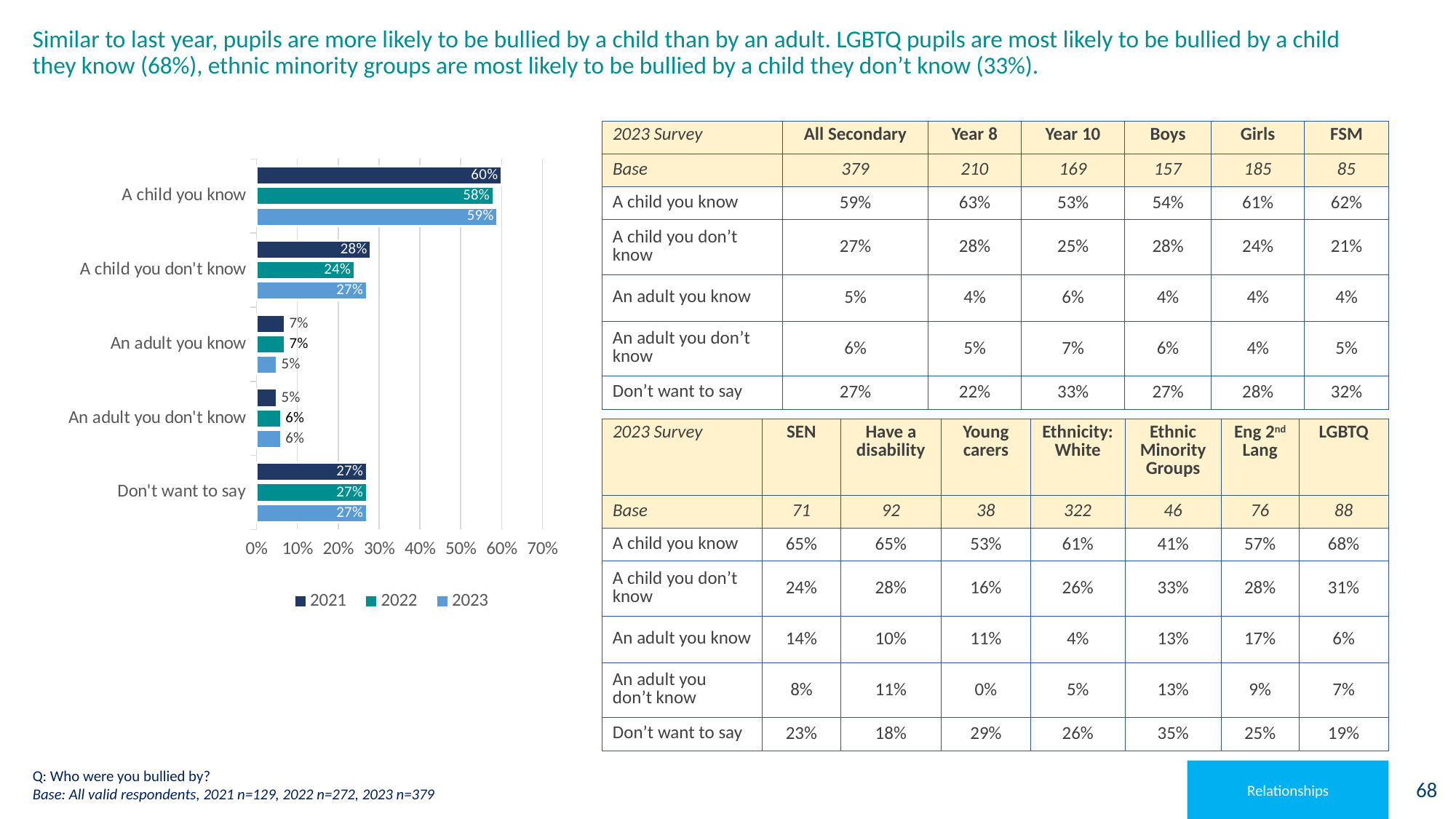
What kind of chart is shown on the slide? bar chart Which is larger for 'A child you don't know': the 2021 value or the 2023 value? 2021 Which category has the lowest value for the 2023 series? An adult you know Is the 2022 value for 'A child you know' greater or less than 50%? greater Which category has the highest value for the 2021 series? A child you know How many categories are shown on the chart? 5 What is the 2021 value for 'An adult you don't know'? 5% How many series does the chart legend list? 3 Which series is shown in the darkest colour in the legend? 2021 What is the difference between the 2021 and 2022 values for 'A child you know'? 2% What is the 2022 value for 'A child you don't know'? 24% What is the 2023 value for 'A child you know'? 59%